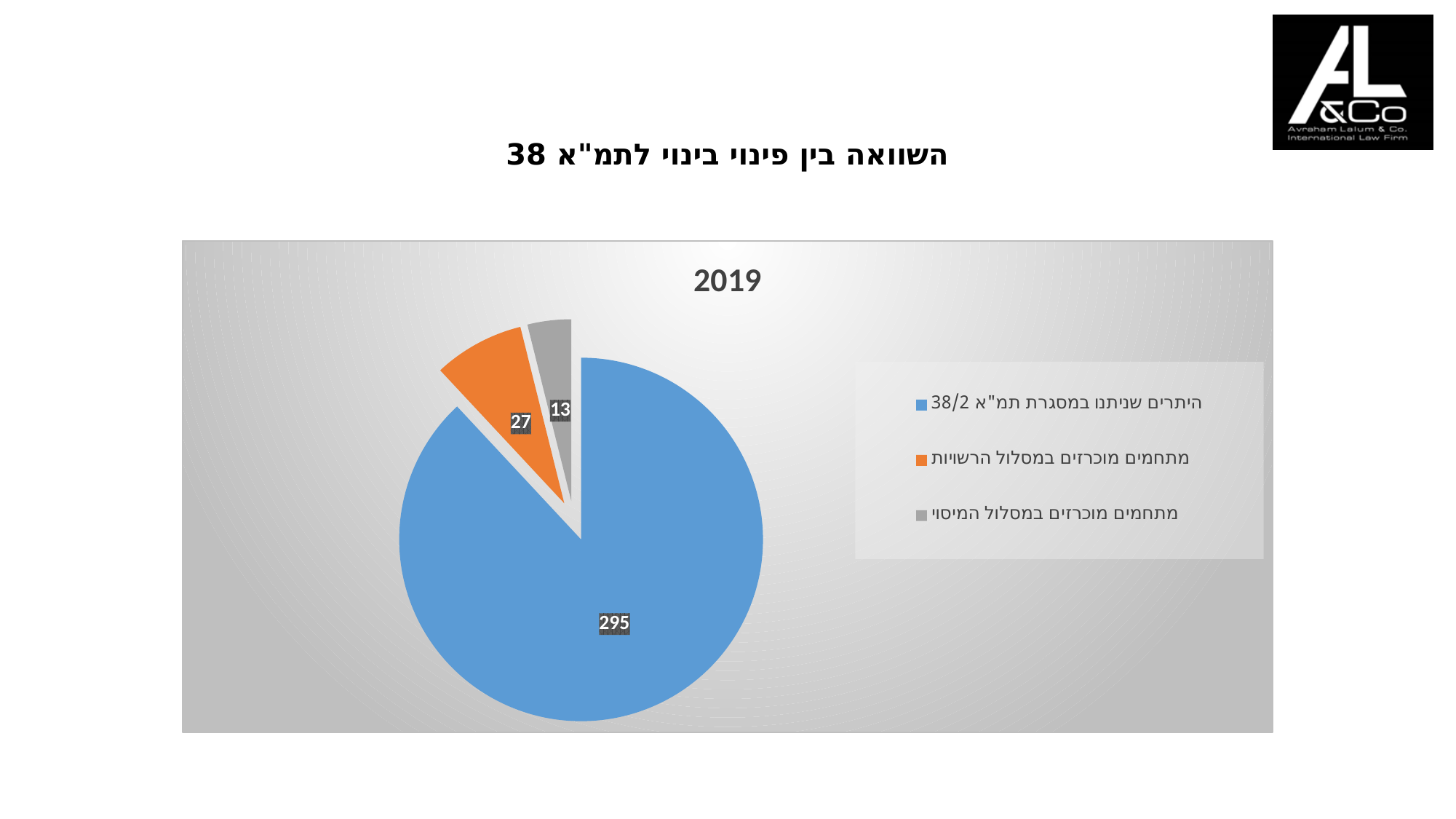
How many slices does the pie chart have? 3 What colour is the slice for מתחמים מוכרזים במסלול הרשויות? orange What is the value for היתרים שניתנו במסגרת תמ"א 38/2? 295 What is the value for מתחמים מוכרזים במסלול הרשויות? 27 Which is larger: the value for מתחמים מוכרזים במסלול הרשויות or the value for מתחמים מוכרזים במסלול המיסוי? מתחמים מוכרזים במסלול הרשויות What type of chart is shown on the slide? pie chart What is the title of the chart? 2019 What is the value for מתחמים מוכרזים במסלול המיסוי? 13 What is the difference between the value for מתחמים מוכרזים במסלול הרשויות and the value for מתחמים מוכרזים במסלול המיסוי? 14 Which category has the smallest slice of the pie? מתחמים מוכרזים במסלול המיסוי Which category has the largest slice of the pie? היתרים שניתנו במסגרת תמ"א 38/2 What is the difference between the value for היתרים שניתנו במסגרת תמ"א 38/2 and the value for מתחמים מוכרזים במסלול הרשויות? 268